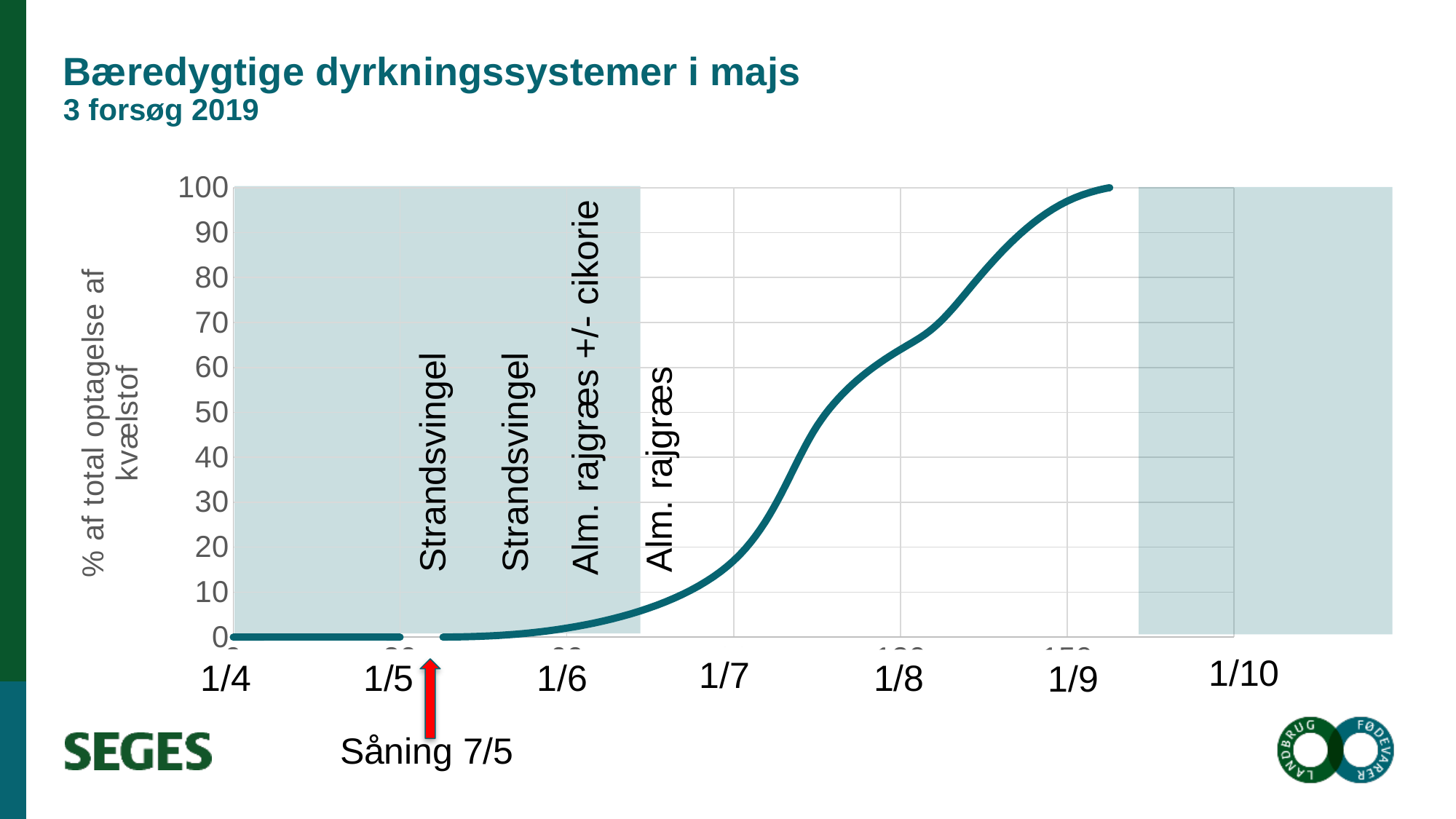
What is the label of the y axis? % af total optagelse af kvælstof Is the value of the curve at 1/6 greater or less than 10? less How many date labels are shown along the x axis? 7 What sowing date is marked by the red arrow below the x axis? Såning 7/5 What is the lowest value shown on the y axis? 0 What is the highest value the curve reaches on the y axis? 100 Is the value of the curve at 1/8 greater or less than 50? greater Is the value of the curve at 1/9 greater or less than 80? greater Does the curve rise or fall from 1/4 to 1/9? rise What kind of chart is shown on the slide? line chart